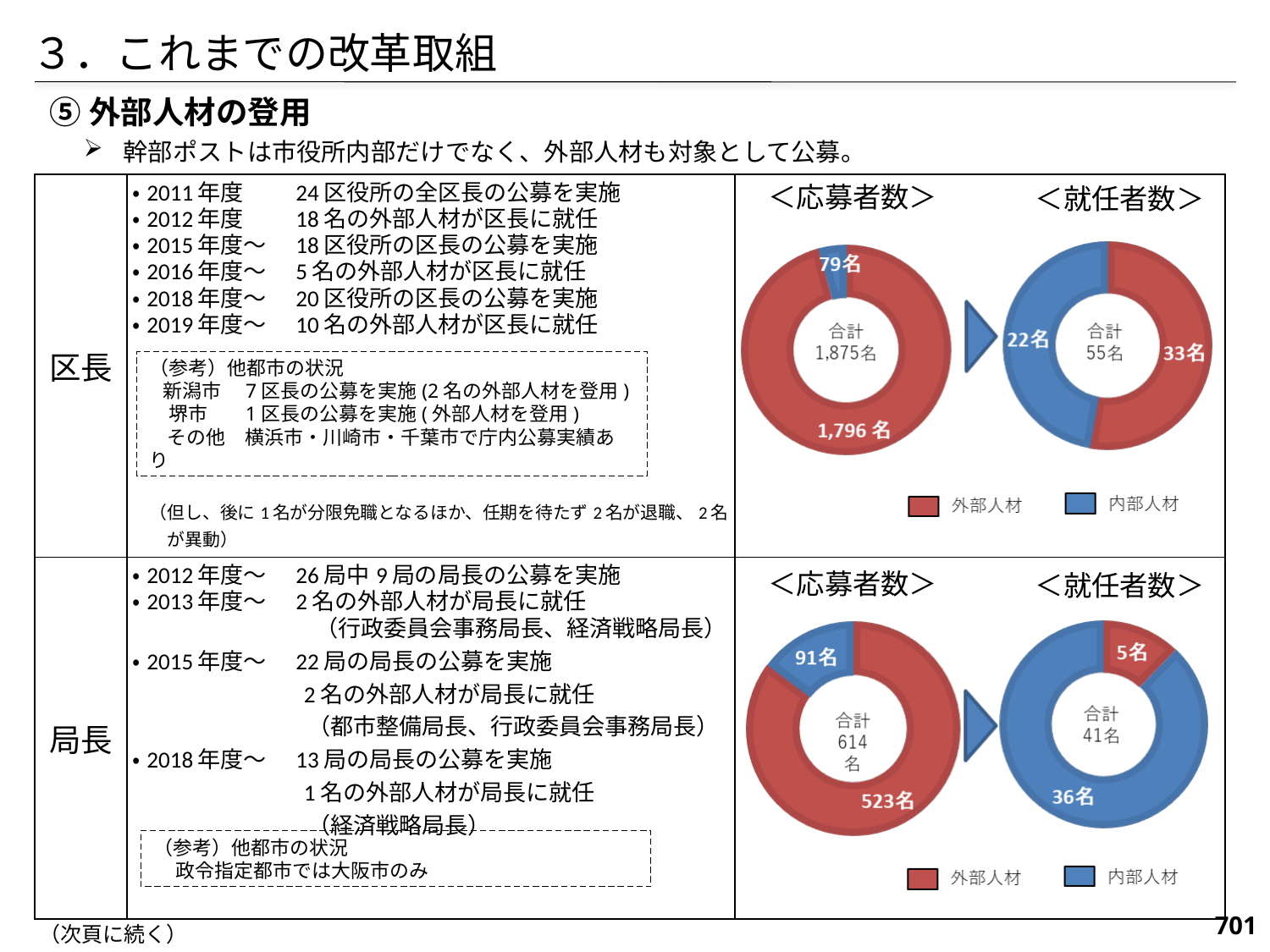
In the 局長 <応募者数> donut chart, what is the value for 内部人材? 91名 In the 区長 <応募者数> donut chart, what is the value for 外部人材? 1,796名 In the 局長 <就任者数> donut chart, which category is larger, 外部人材 or 内部人材? 内部人材 In the 局長 <応募者数> donut chart, what is the total (合計) shown in the centre? 614名 In the 区長 <就任者数> donut chart, what is the difference between 外部人材 and 内部人材? 11名 In the 区長 <応募者数> donut chart, what is the value for 内部人材? 79名 In the 局長 <就任者数> donut chart, what is the value for 外部人材? 5名 What type of chart is used for the 区長 <応募者数> figure? Donut (pie) chart In the 区長 <就任者数> donut chart, what is the value for 外部人材? 33名 How many series does the legend below the 局長 charts list? 2 In the 区長 <就任者数> donut chart, what is the total (合計) shown in the centre? 55名 In the 局長 <応募者数> donut chart, what is the difference between 外部人材 and 内部人材? 432名